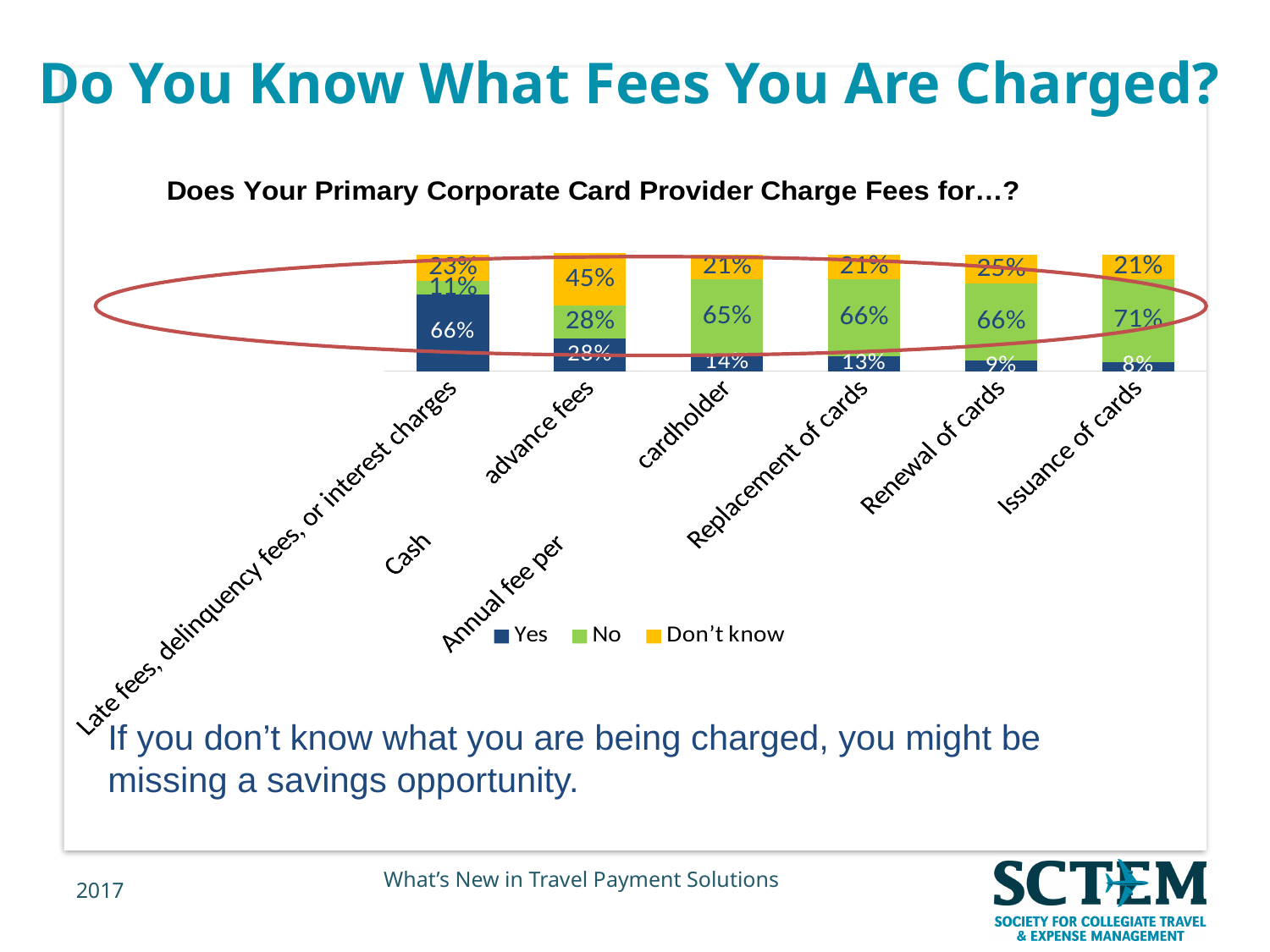
What is the difference between the 'Don't know' values for Renewal of cards and Issuance of cards? 4 percentage points Which category has the highest 'Don't know' value? Cash advance fees What are the three entries in the chart's legend? Yes, No, Don't know Which category has the lowest 'Yes' value? Issuance of cards What is the 'Yes' value for Late fees, delinquency fees, or interest charges? 66% How many series does the legend list? 3 What is the 'Yes' value for Renewal of cards? 9% Which is larger: the 'Yes' value for Late fees, delinquency fees, or interest charges, or the 'Yes' value for Annual fee per cardholder? Late fees, delinquency fees, or interest charges How many fee categories are shown on the x axis? 6 What is the 'No' value for Issuance of cards? 71% What kind of chart is shown on the slide? Stacked bar chart What is the 'Don't know' value for Cash advance fees? 45%